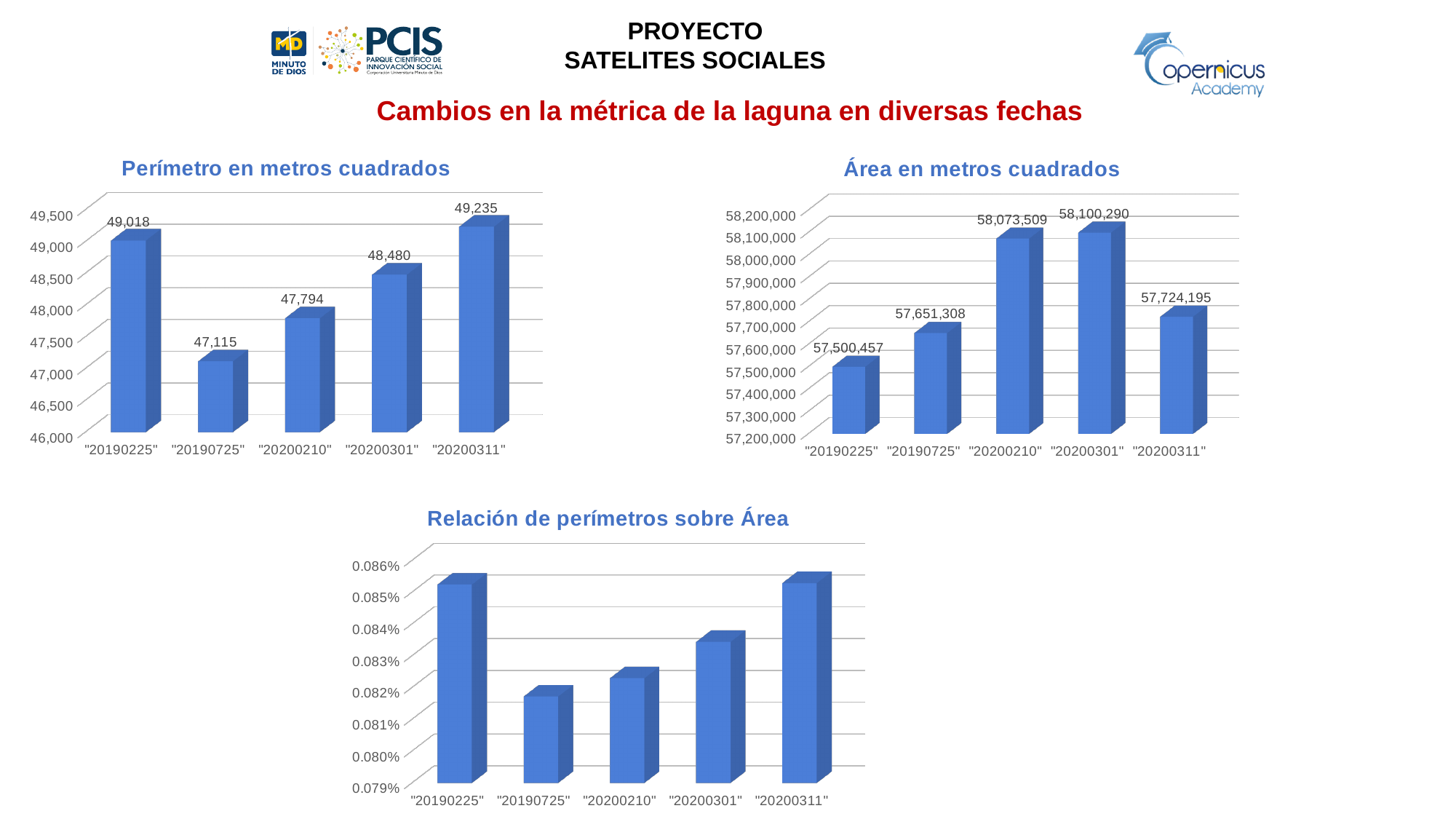
In the chart titled "Perímetro en metros cuadrados", which date has the highest value? "20200311" In the chart titled "Relación de perímetros sobre Área", is the value for "20190725" greater or less than 0.084%? less What kind of chart is the chart titled "Perímetro en metros cuadrados"? bar chart In the chart titled "Perímetro en metros cuadrados", what is the difference between the values for "20200311" and "20190725"? 2,120 In the chart titled "Relación de perímetros sobre Área", is the value for "20190225" greater or less than 0.084%? greater In the chart titled "Perímetro en metros cuadrados", what is the value for "20190725"? 47,115 In the chart titled "Área en metros cuadrados", which is larger, the value for "20190725" or the value for "20200311"? "20200311" In the chart titled "Área en metros cuadrados", which date has the lowest value? "20190225" In the chart titled "Área en metros cuadrados", what is the value for "20200210"? 58,073,509 In the chart titled "Área en metros cuadrados", which date has the highest value? "20200301" In the chart titled "Perímetro en metros cuadrados", which date has the lowest value? "20190725" How many dates are shown on the x axis of the chart titled "Relación de perímetros sobre Área"? 5